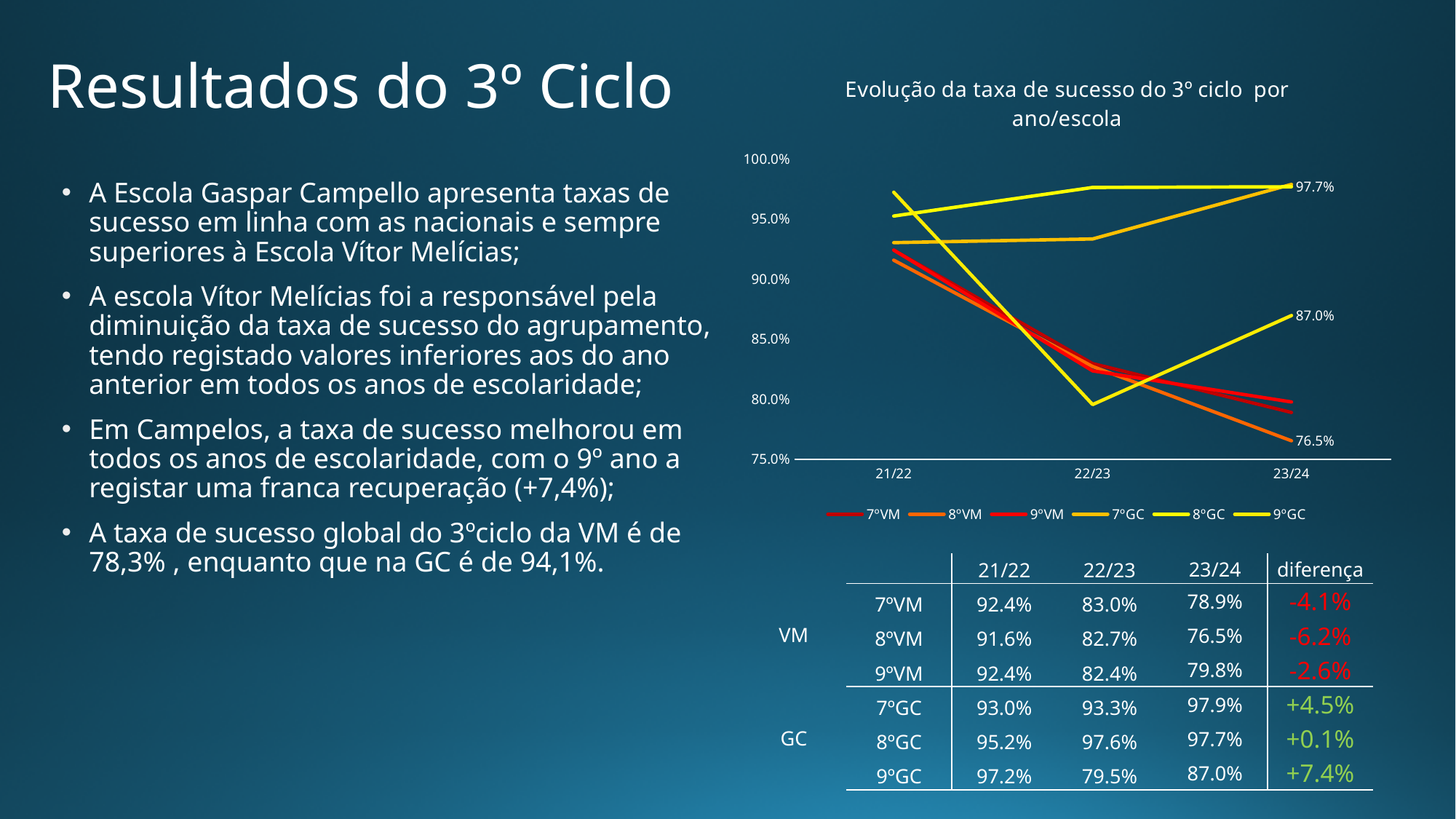
Is the value for 9ºGC in 22/23 greater or less than 85.0%? less Is the value for 7ºGC in 22/23 greater or less than 90.0%? greater What is the value for 8ºGC in 23/24? 97.7% How many school years are shown on the x axis of the chart? 3 What is the difference between the 8ºGC and 9ºGC values in 23/24? 10.7 percentage points Which series has the lowest value in 23/24? 8ºVM Does the 8ºVM line rise or fall from 21/22 to 23/24? falls How many series does the chart legend list? 6 What is the value for 8ºVM in 23/24? 76.5% Which series has the highest value in 21/22? 9ºGC What kind of chart is shown on the slide? line chart What is the value for 9ºGC in 23/24? 87.0%